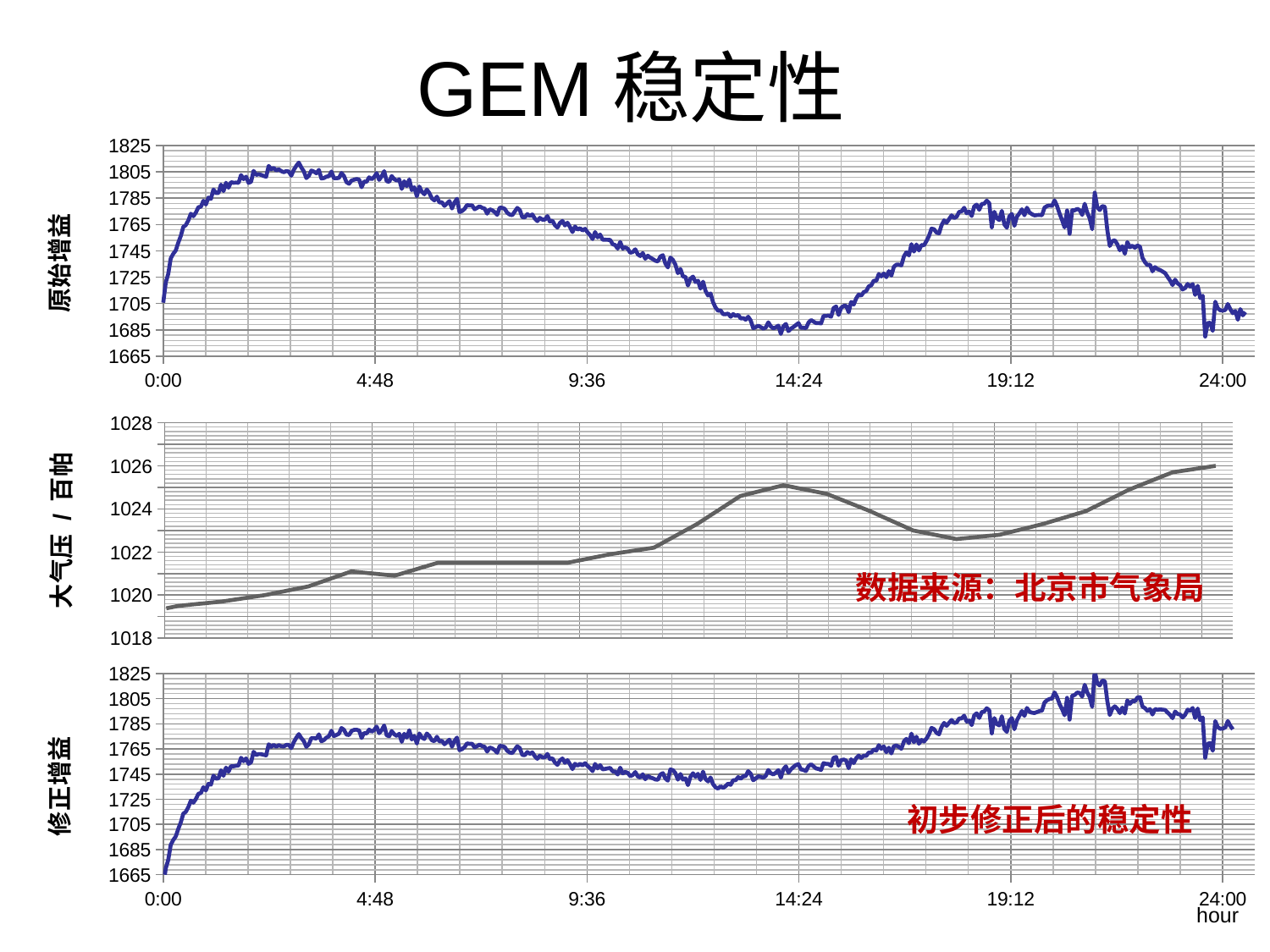
According to the red text on the middle chart, what is the data source? 北京市气象局 In the top chart (原始增益), is the value at 14:24 greater or less than 1705? less In the middle chart (大气压 / 百帕), does the line rise or fall between 19:12 and 24:00? rise What kind of chart is the top chart (原始增益)? line chart What unit is labelled on the x axis of the bottom chart? hour In the middle chart (大气压 / 百帕), is the value at 0:00 greater or less than 1020? less In the top chart (原始增益), is the value at 4:48 greater or less than 1785? greater In the bottom chart (修正增益), does the line rise or fall between 4:48 and 9:36? fall How many charts are shown on the slide? 3 In the top chart (原始增益), does the line rise or fall between 4:48 and 9:36? fall